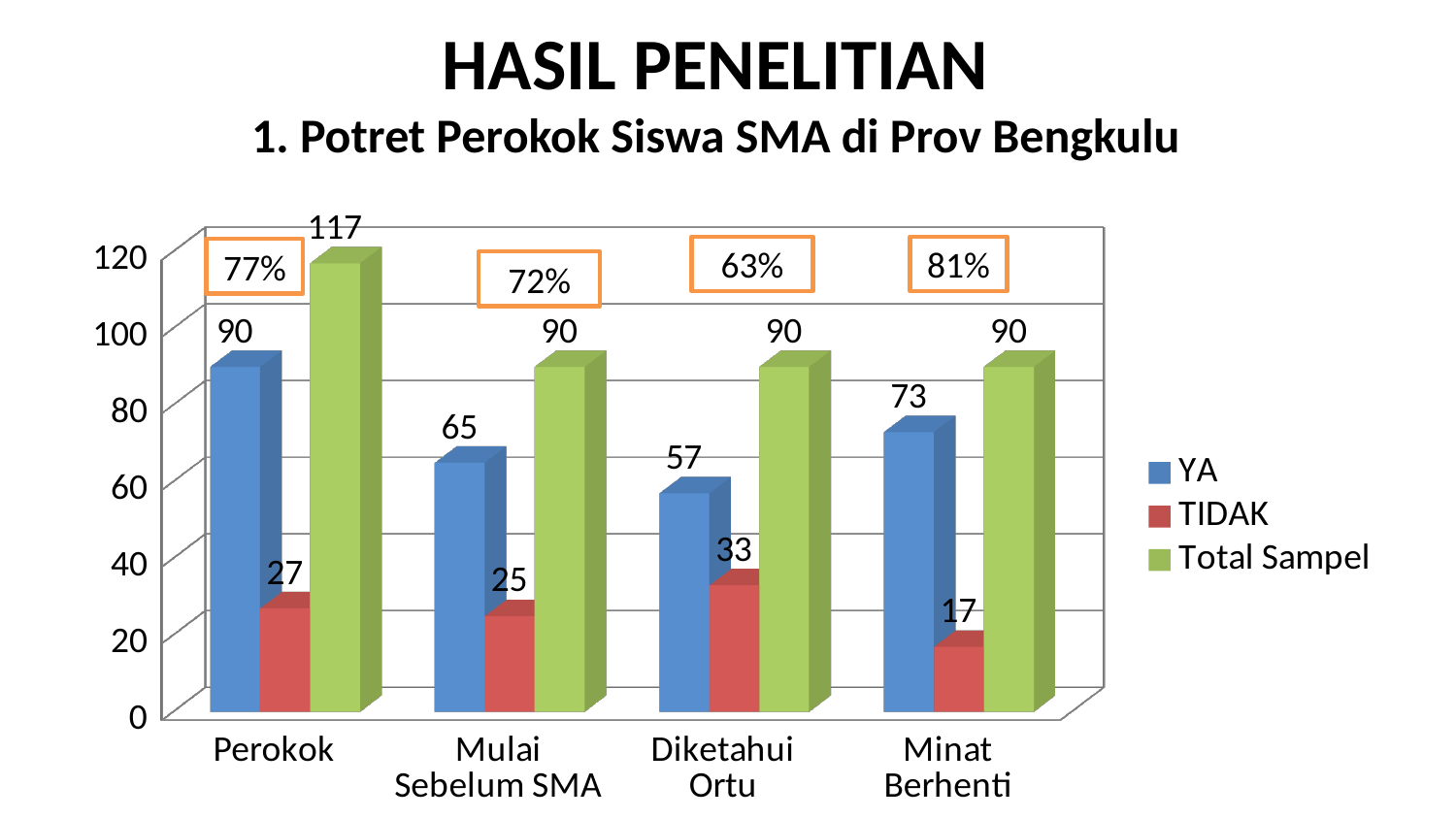
What is the YA value for Minat Berhenti? 73 What percentage is shown in the orange box above the Minat Berhenti category? 81% What is the difference between the YA and TIDAK values for Mulai Sebelum SMA? 40 What kind of chart is shown on the slide? Bar chart Which is larger, the TIDAK value for Perokok or the TIDAK value for Mulai Sebelum SMA? Perokok Which category has the lowest TIDAK value? Minat Berhenti How many categories are shown on the x axis? 4 What is the TIDAK value for Diketahui Ortu? 33 Which category has the lowest YA value? Diketahui Ortu What is the YA value for Perokok? 90 How many series does the legend list? 3 What is the Total Sampel value for Perokok? 117